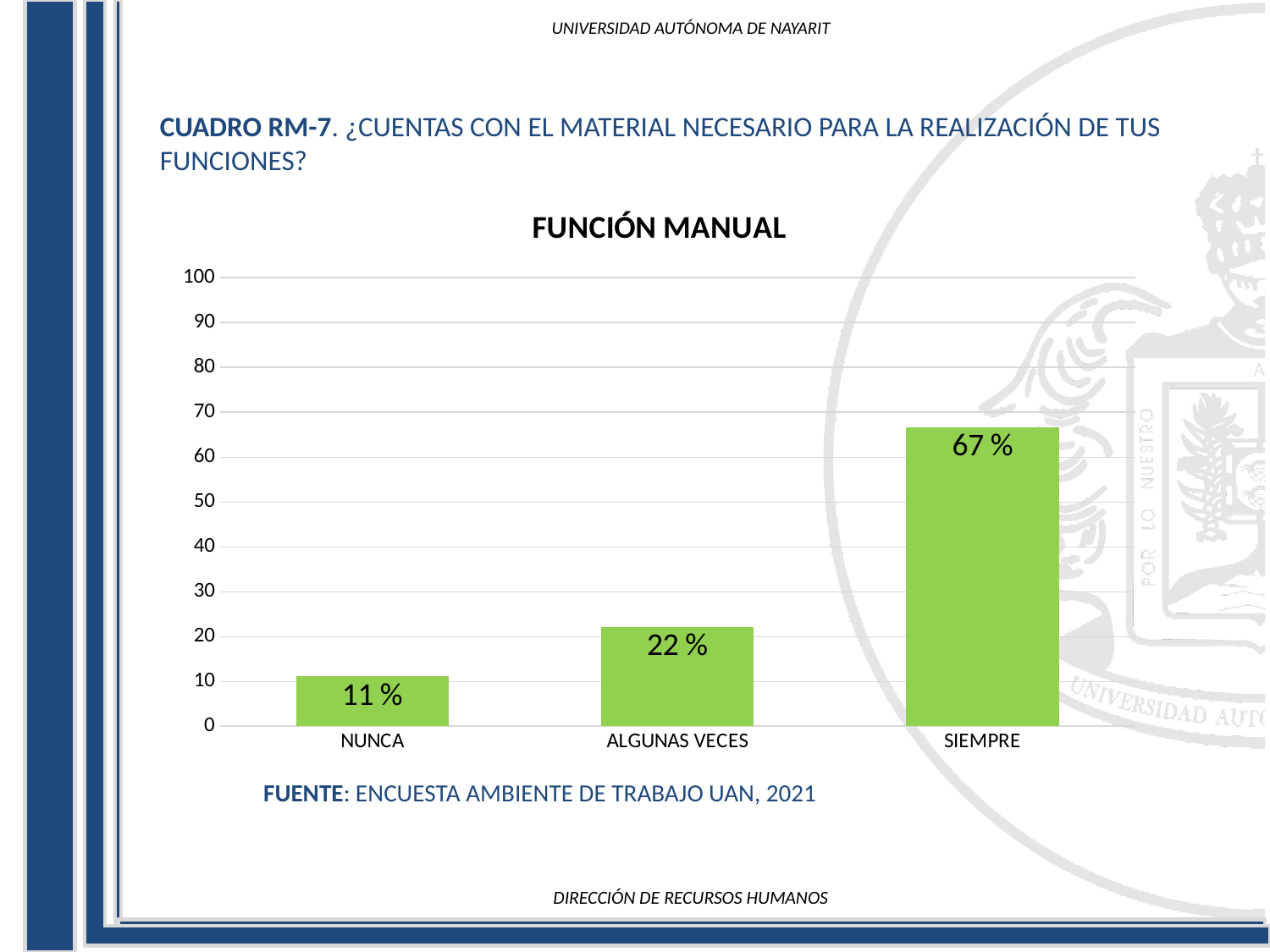
What is the value for NUNCA? 11 % What kind of chart is shown? bar chart What is the difference between the values for ALGUNAS VECES and NUNCA? 11 % What is the value for SIEMPRE? 67 % Which category has the lowest value? NUNCA How many categories are shown on the x axis? 3 Is the value for SIEMPRE greater or less than 50? greater Which is larger, the value for ALGUNAS VECES or the value for NUNCA? ALGUNAS VECES What is the title of the chart? FUNCIÓN MANUAL Which category has the highest value? SIEMPRE What is the value for ALGUNAS VECES? 22 % What is the difference between the values for SIEMPRE and ALGUNAS VECES? 45 %